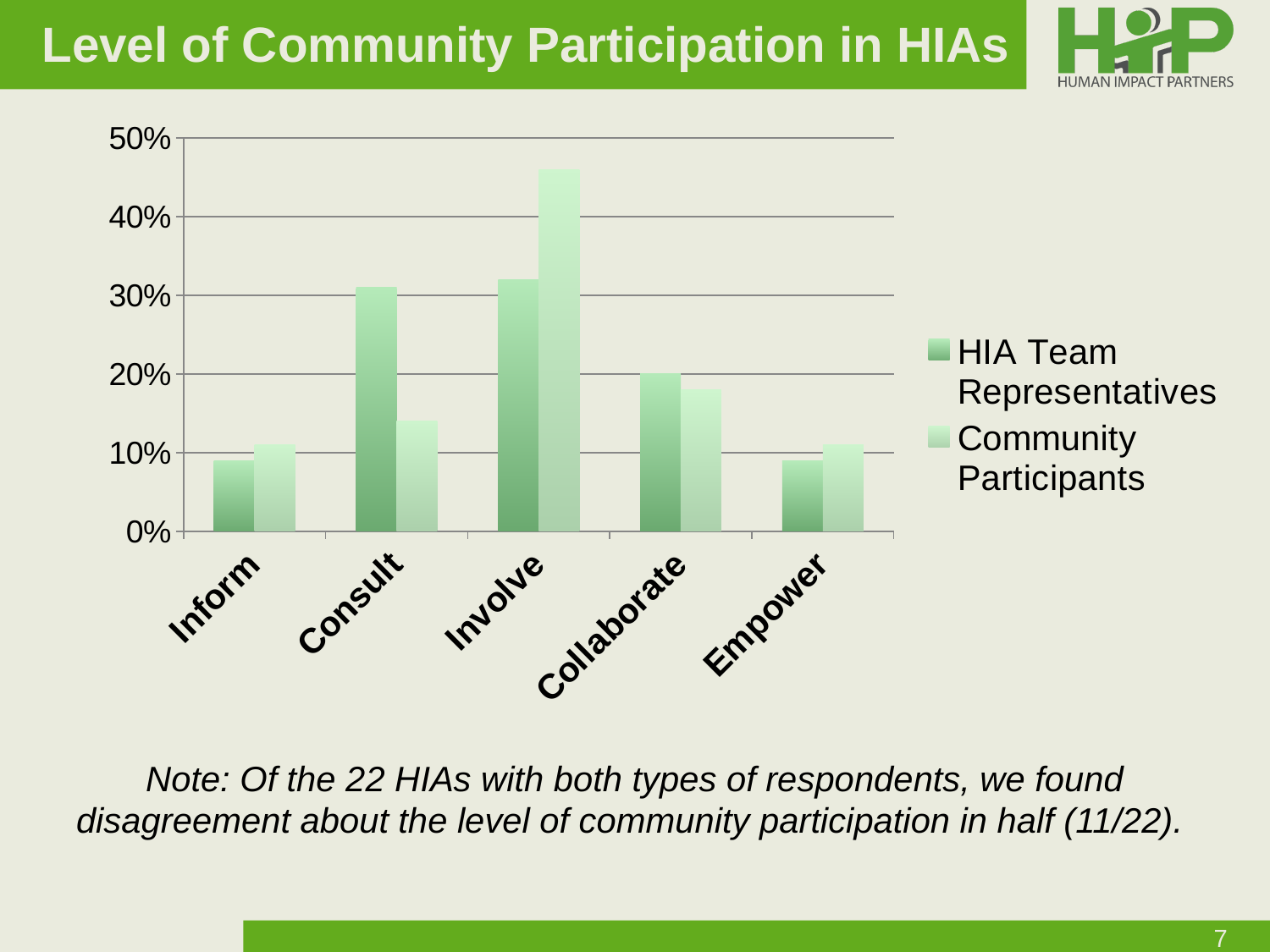
How many series does the chart's legend list? 2 Is the HIA Team Representatives value for Empower greater or less than 20%? less Which category has the highest value for Community Participants? Involve What kind of chart is shown on the slide? bar chart Is the Community Participants value for Involve greater or less than 40%? greater What are the two series named in the chart's legend? HIA Team Representatives and Community Participants Is the Community Participants value for Consult greater or less than 20%? less For Involve, which series has the larger value: HIA Team Representatives or Community Participants? Community Participants What is the title of the slide containing the chart? Level of Community Participation in HIAs How many categories are shown on the x axis of the chart? 5 For Consult, which series has the larger value: HIA Team Representatives or Community Participants? HIA Team Representatives